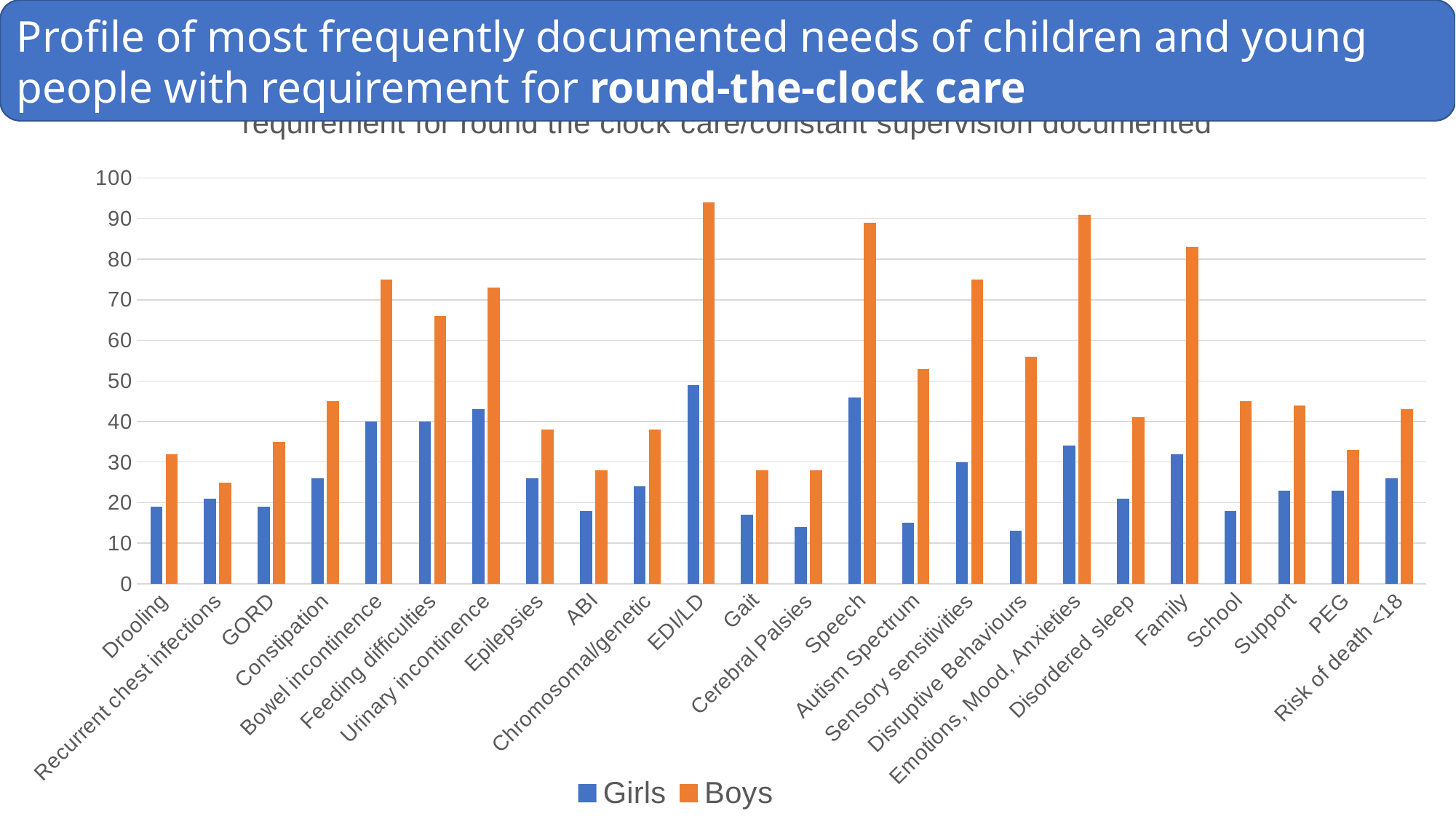
Which colour represents the Boys series in the chart? orange Is the Boys value for Family greater or less than 80? greater For Speech, which series has the larger value, Girls or Boys? Boys Is the Girls value for Speech greater or less than 50? less What kind of chart is shown on the slide? bar chart How many categories are shown along the x axis? 24 Is the Boys value for Bowel incontinence greater or less than 70? greater How many series does the legend list? 2 For the Boys series, which is larger: Sensory sensitivities or Autism Spectrum? Sensory sensitivities